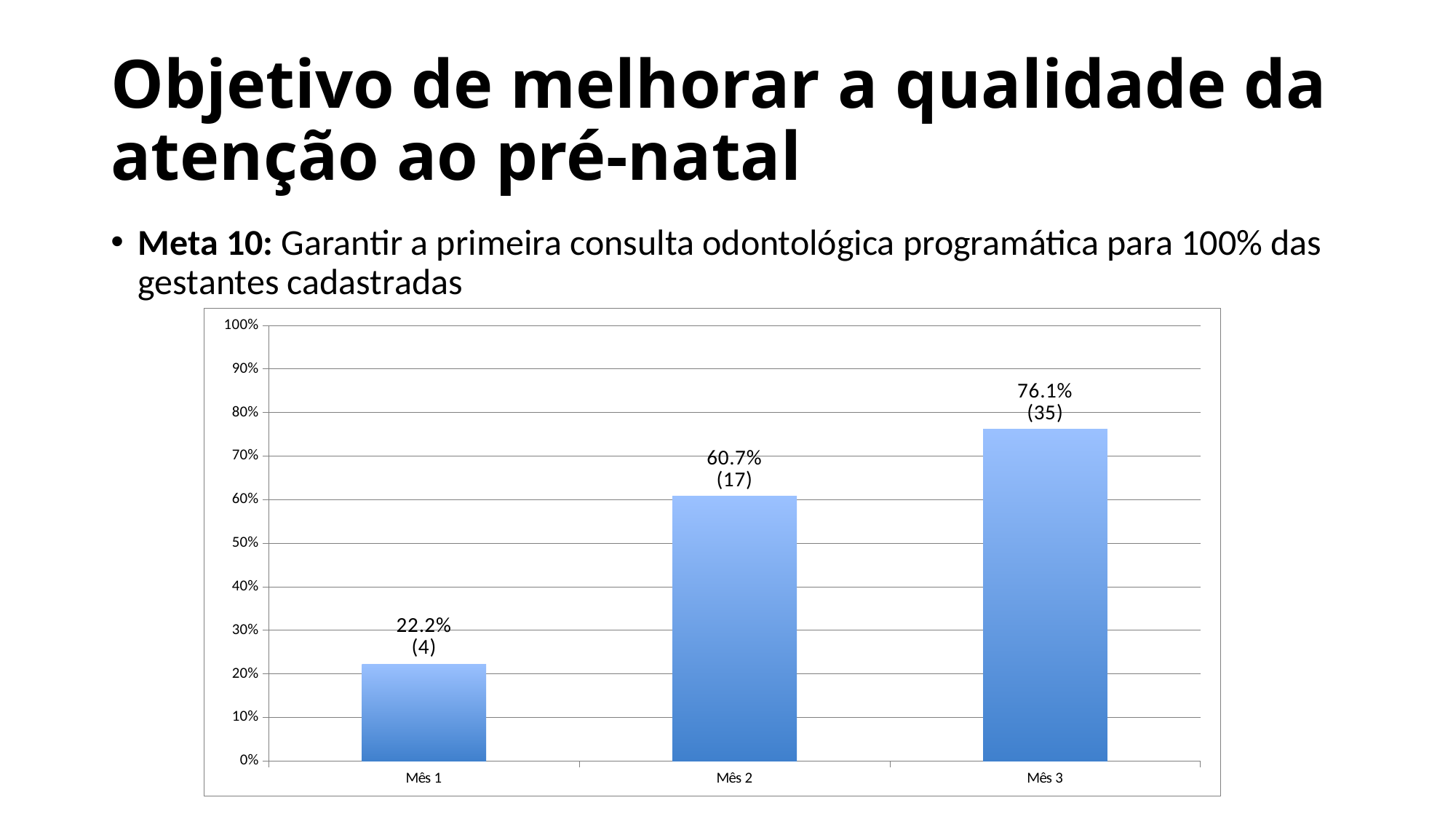
What is the percentage value shown for Mês 3? 76.1% Do the values rise or fall from Mês 1 to Mês 3? Rise What is the percentage value shown for Mês 1? 22.2% How many categories are shown on the x axis? 3 What is the percentage value shown for Mês 2? 60.7% What count is shown in parentheses for Mês 3? 35 Which is larger, the value for Mês 1 or the value for Mês 2? Mês 2 What is the difference in percentage points between Mês 3 and Mês 2? 15.4 What kind of chart is shown on the slide? Bar chart Which month has the highest percentage? Mês 3 Which month has the lowest percentage? Mês 1 What count is shown in parentheses for Mês 2? 17